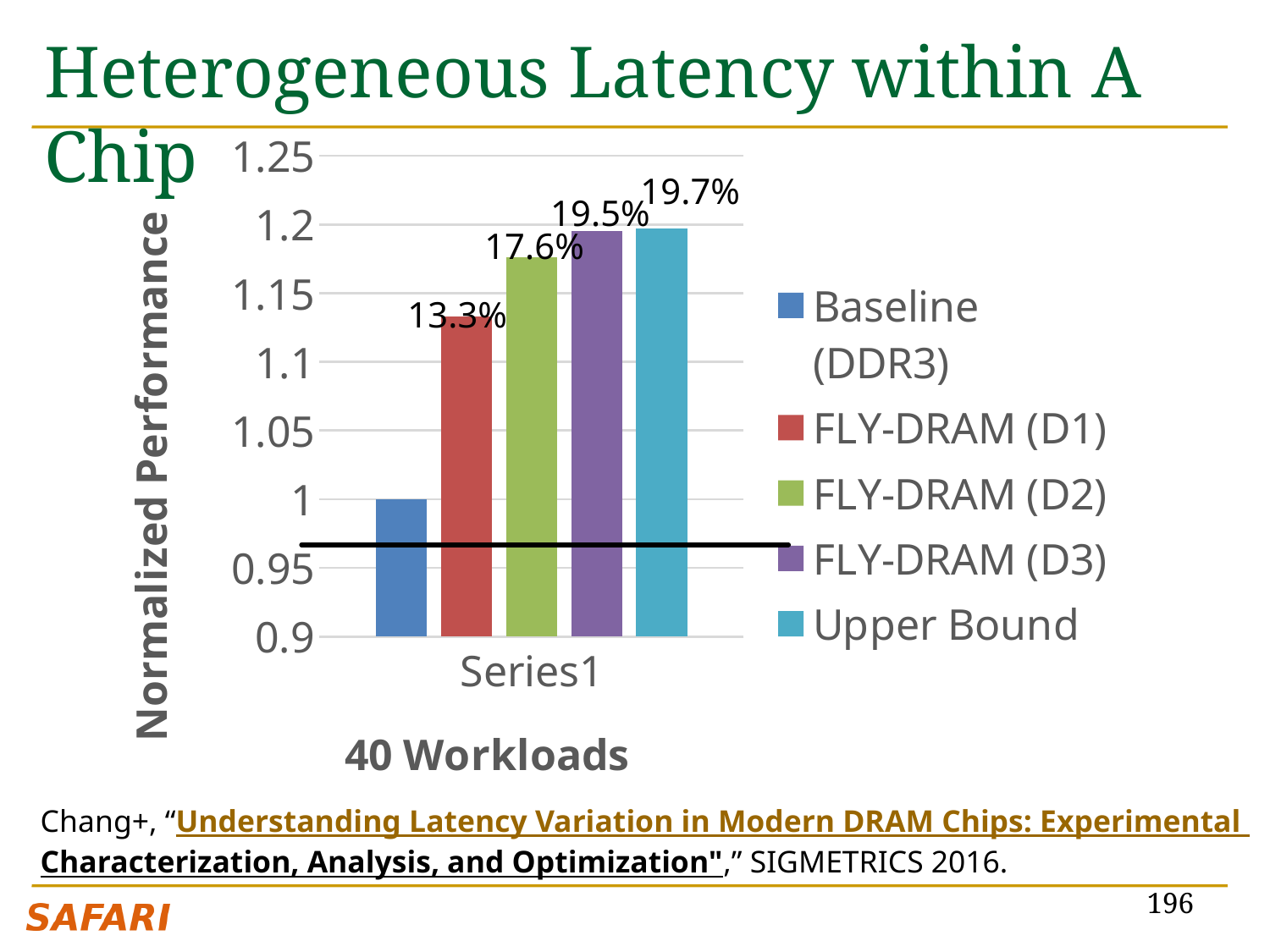
How many series does the legend list? 5 What data label is printed above the FLY-DRAM (D3) bar? 19.5% What normalized performance value does the Baseline (DDR3) bar reach on the y axis? 1 What data label is printed above the FLY-DRAM (D2) bar? 17.6% What data label is printed above the FLY-DRAM (D1) bar? 13.3% Is the value for FLY-DRAM (D2) greater or less than 1.15? greater What data label is printed above the Upper Bound bar? 19.7% Which series has the lowest bar? Baseline (DDR3) Which series has the highest bar, according to the printed labels? Upper Bound What kind of chart is shown on the slide? bar chart What is the title of the y axis? Normalized Performance Is the value for FLY-DRAM (D1) greater or less than 1.1? greater